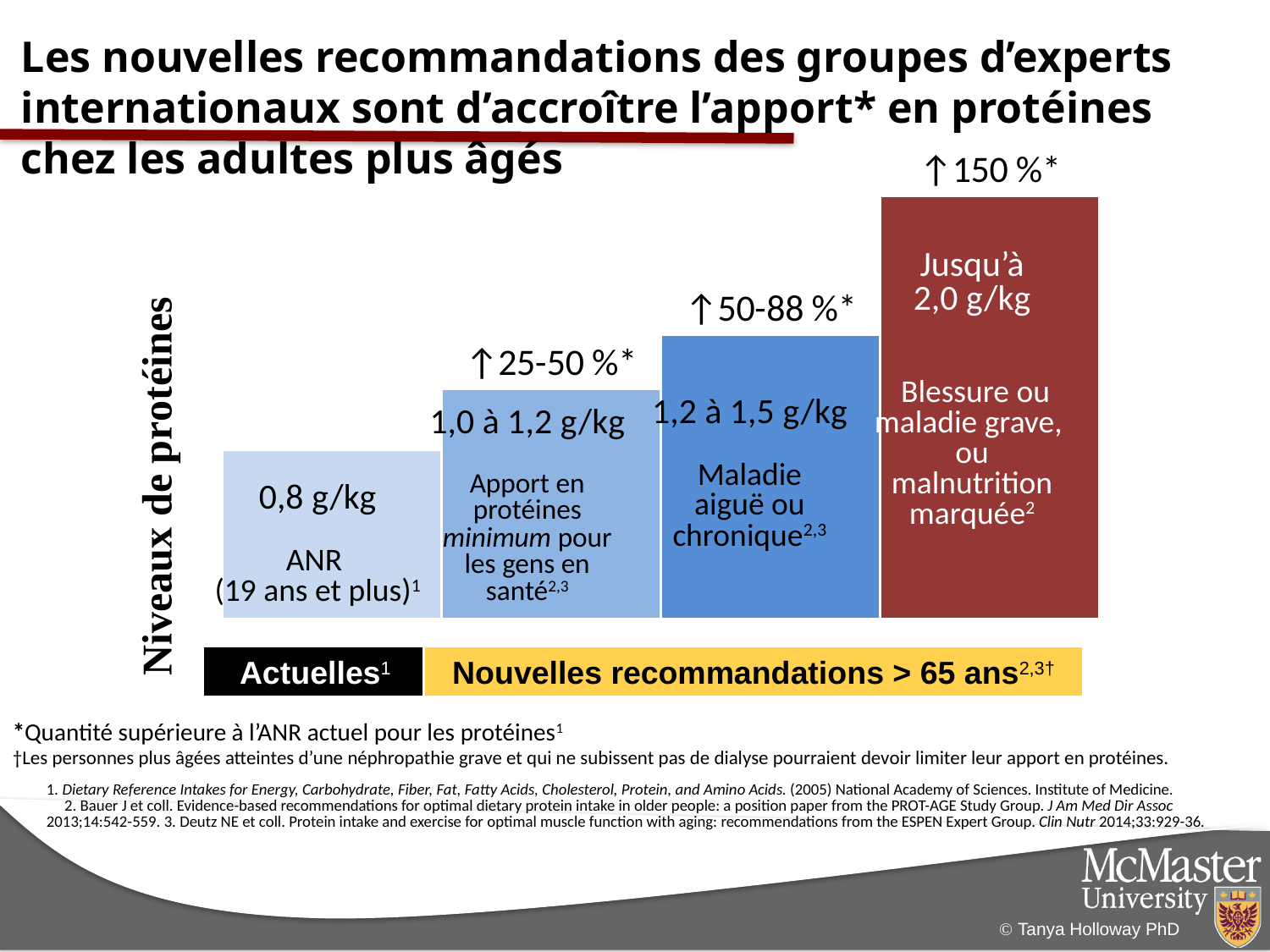
What protein level is shown for the ANR (19 ans et plus) bar? 0,8 g/kg What kind of chart is shown on the slide? Bar chart What protein level is shown for the 'Apport en protéines minimum pour les gens en santé' bar? 1,0 à 1,2 g/kg What protein level is shown for the 'Maladie aiguë ou chronique' bar? 1,2 à 1,5 g/kg What is the label on the vertical axis of the chart? Niveaux de protéines Which bar is the tallest? Blessure ou maladie grave, ou malnutrition marquée What percentage increase is printed above the 'Maladie aiguë ou chronique' bar? ↑ 50-88 %* Which bar is the shortest? ANR (19 ans et plus) Do the bars rise or fall from left to right? Rise How many bars are shown in the chart? 4 What protein level is shown for the 'Blessure ou maladie grave, ou malnutrition marquée' bar? Jusqu'à 2,0 g/kg What percentage increase is printed above the tallest bar? ↑ 150 %*